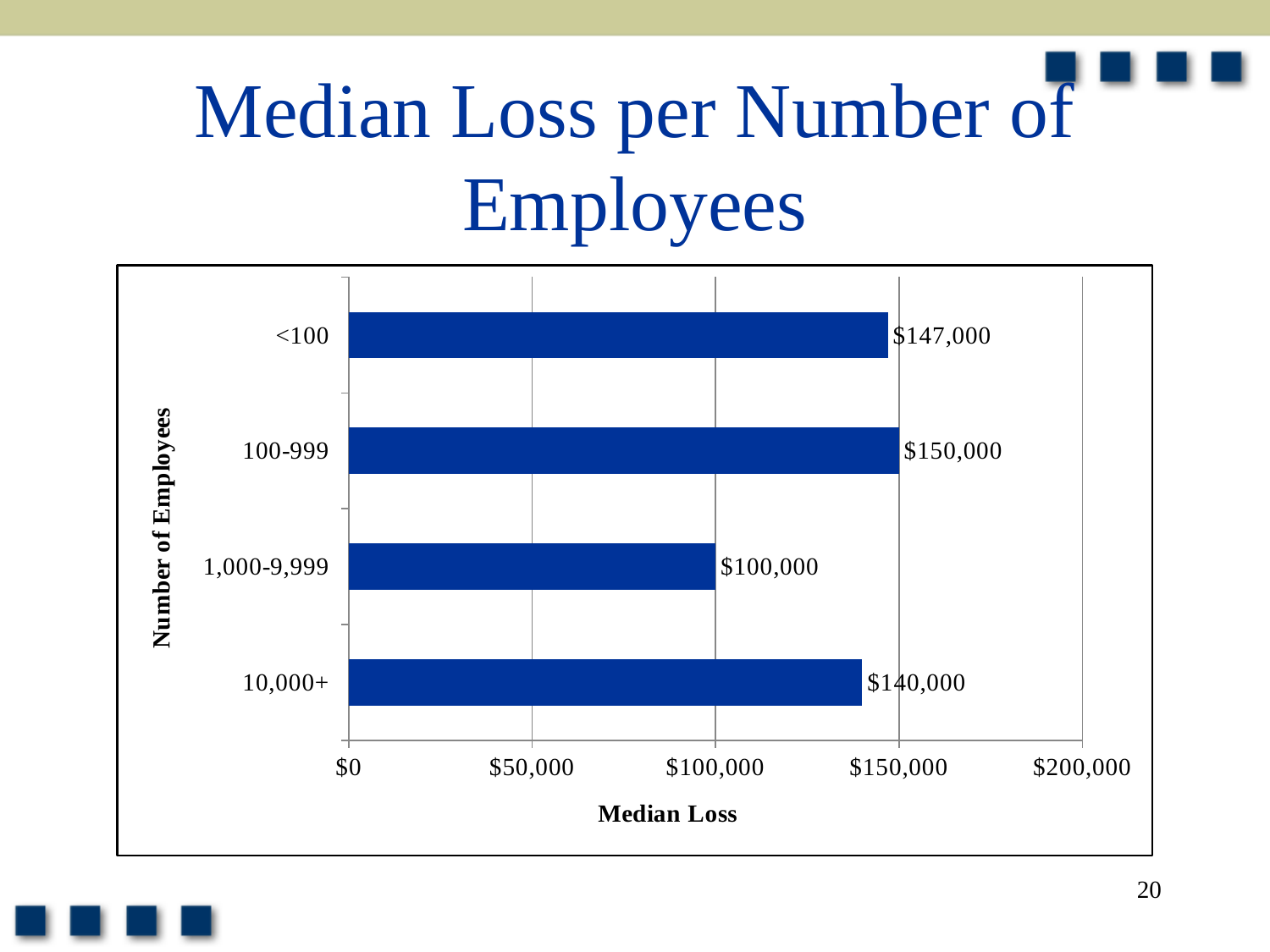
How many employee-count categories are shown in the chart? 4 What is the median loss for organizations with 1,000-9,999 employees? $100,000 What is the difference in median loss between the 100-999 and 1,000-9,999 categories? $50,000 What is the median loss for organizations with 10,000+ employees? $140,000 What is the difference in median loss between the <100 and 10,000+ categories? $7,000 Which employee-count category has the lowest median loss? 1,000-9,999 Which has a larger median loss: <100 employees or 10,000+ employees? <100 What is the label of the horizontal axis of the chart? Median Loss Which employee-count category has the highest median loss? 100-999 What is the median loss for organizations with fewer than 100 employees? $147,000 What is the median loss for organizations with 100-999 employees? $150,000 What type of chart is shown on the slide? Bar chart